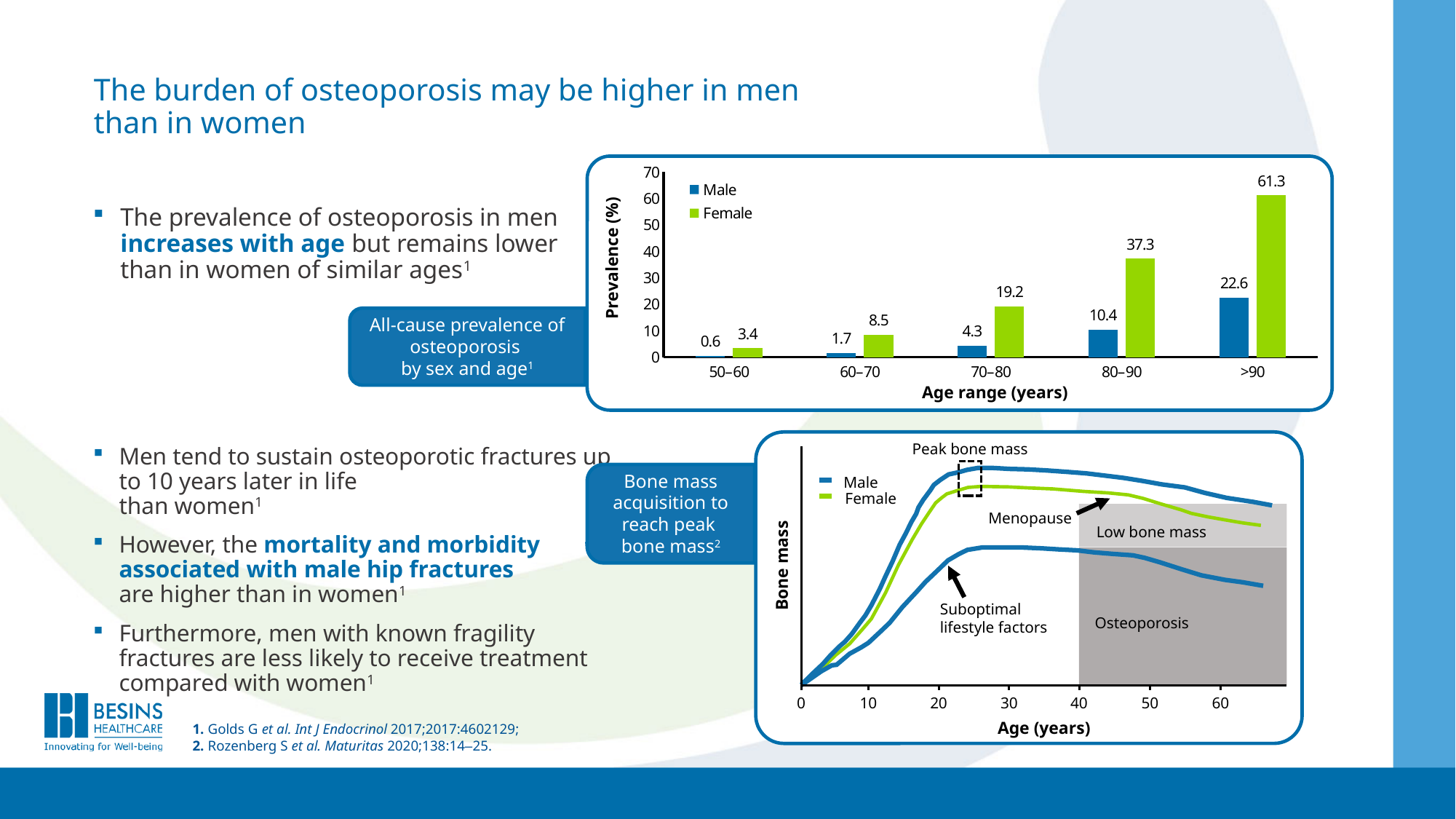
In the bar chart of all-cause prevalence of osteoporosis by sex and age, what is the difference between female and male prevalence in the 70–80 age range? 14.9 In the bar chart of all-cause prevalence of osteoporosis by sex and age, does male prevalence rise or fall as age range increases? Rises In the bar chart of all-cause prevalence of osteoporosis by sex and age, how many series does the legend list? 2 In the bar chart of all-cause prevalence of osteoporosis by sex and age, how many age ranges are shown on the x axis? 5 In the bar chart of all-cause prevalence of osteoporosis by sex and age, which is larger in the 60–70 age range: male or female prevalence? Female In the bone mass acquisition chart, what is the label on the x axis? Age (years) In the bar chart of all-cause prevalence of osteoporosis by sex and age, which age range has the lowest male prevalence? 50–60 In the bar chart of all-cause prevalence of osteoporosis by sex and age, what is the prevalence for males aged 50–60? 0.6 What kind of chart is the bone mass acquisition chart at the bottom right of the slide? Line chart In the bar chart of all-cause prevalence of osteoporosis by sex and age, which age range has the highest female prevalence? >90 In the bar chart of all-cause prevalence of osteoporosis by sex and age, what is the prevalence for males aged 80–90? 10.4 In the bar chart of all-cause prevalence of osteoporosis by sex and age, what is the prevalence for females aged >90? 61.3